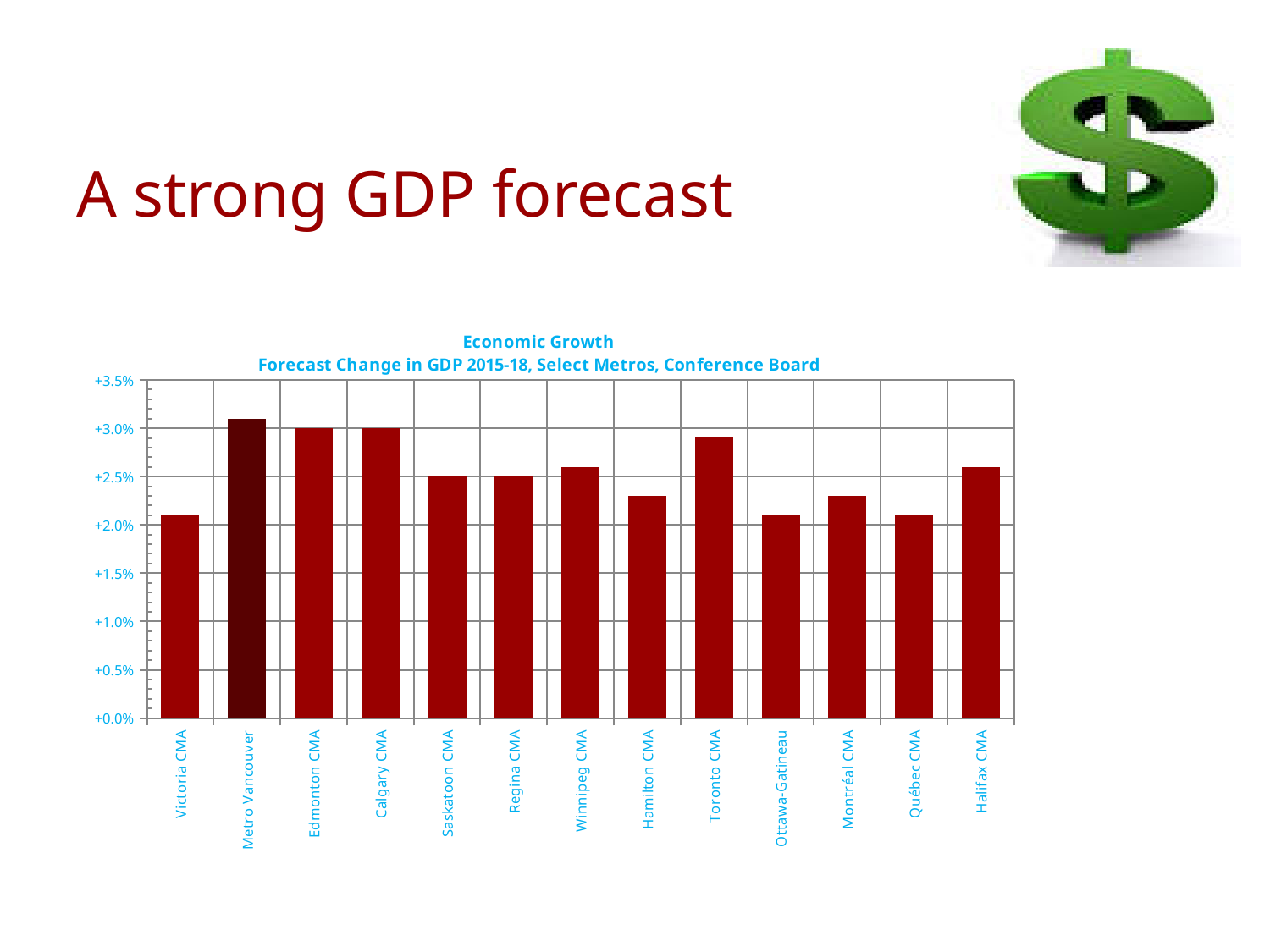
Is the value for Hamilton CMA greater or less than +2.5%? less Is the value for Victoria CMA greater or less than +2.5%? less What kind of chart is shown on the slide? Bar chart What is the forecast change in GDP for Edmonton CMA? +3.0% Which has the larger forecast GDP change, Metro Vancouver or Victoria CMA? Metro Vancouver Is the value for Toronto CMA greater or less than +2.5%? greater What is the forecast change in GDP for Saskatoon CMA? +2.5% How many metros (categories) are shown on the x axis of the chart? 13 Which metro has the highest forecast GDP change in the chart? Metro Vancouver Which bar in the chart is drawn in a darker colour than the others? Metro Vancouver Which has the larger forecast GDP change, Toronto CMA or Hamilton CMA? Toronto CMA